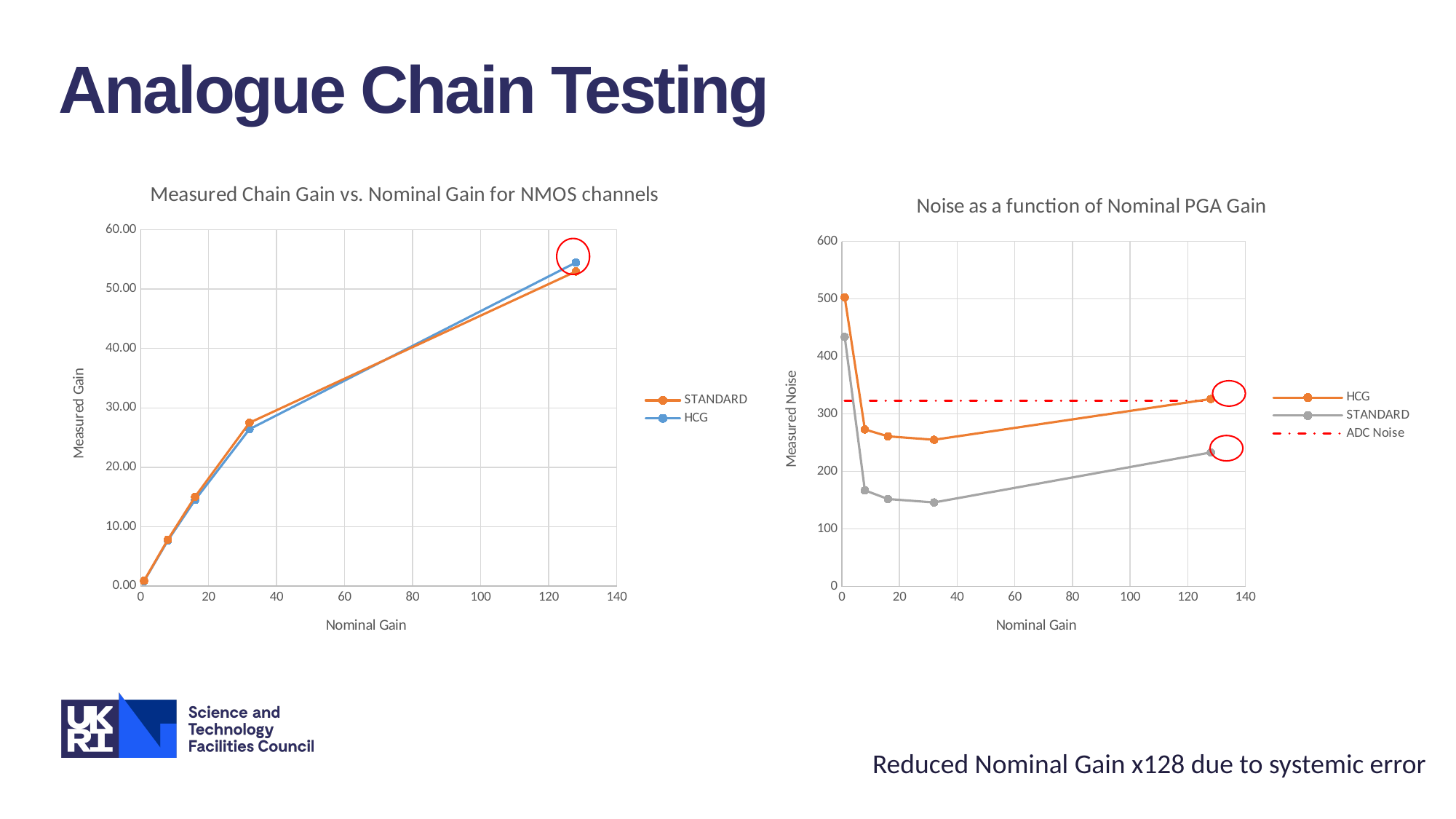
In the right chart, 'Noise as a function of Nominal PGA Gain', is the HCG measured noise at nominal gain 8 greater or less than 300? less In the left chart, 'Measured Chain Gain vs. Nominal Gain for NMOS channels', is the HCG measured gain at nominal gain 32 greater or less than 30.00? less In the left chart, 'Measured Chain Gain vs. Nominal Gain for NMOS channels', does the measured gain rise or fall as nominal gain increases? Rise In the right chart, 'Noise as a function of Nominal PGA Gain', how many entries does the legend list? 3 In the left chart, 'Measured Chain Gain vs. Nominal Gain for NMOS channels', is the STANDARD measured gain at nominal gain 128 greater or less than 50.00? greater What type of chart is the left chart, 'Measured Chain Gain vs. Nominal Gain for NMOS channels'? Line chart In the right chart, 'Noise as a function of Nominal PGA Gain', what line style is used for the ADC Noise series? Red dash-dot line In the left chart, 'Measured Chain Gain vs. Nominal Gain for NMOS channels', how many series does the legend list? 2 In the left chart, 'Measured Chain Gain vs. Nominal Gain for NMOS channels', how many data points does the STANDARD series have? 5 In the right chart, 'Noise as a function of Nominal PGA Gain', which series has the higher measured noise at nominal gain 128, HCG or STANDARD? HCG